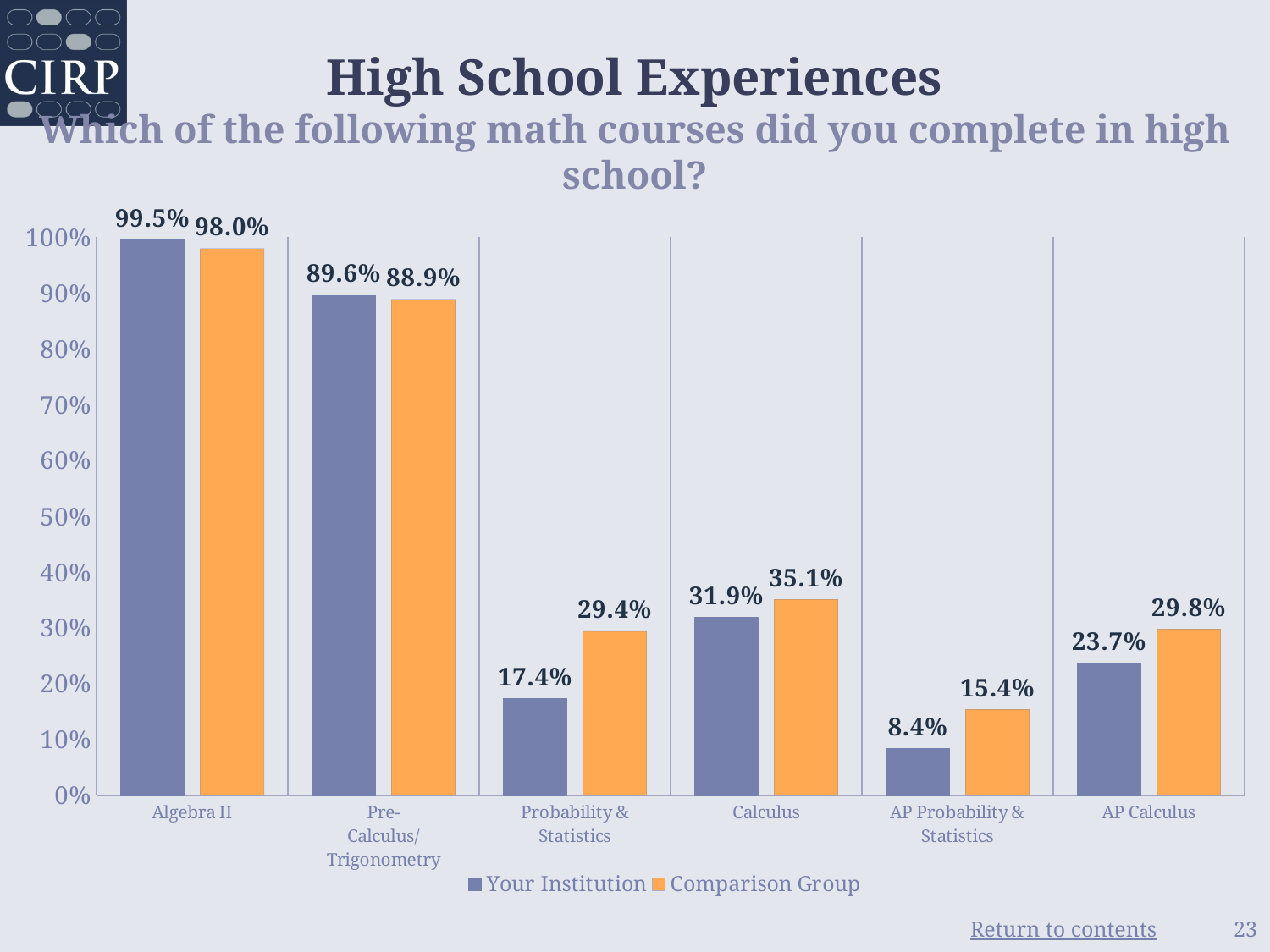
How many series does the legend list? 2 What is the Your Institution value for AP Calculus? 23.7% How many math courses are shown on the x axis? 6 Which math course has the lowest Your Institution value? AP Probability & Statistics Which math course has the highest Comparison Group value? Algebra II For Calculus, which is larger: Your Institution or Comparison Group? Comparison Group Which colour represents the Comparison Group series? orange What is the difference between the Comparison Group and Your Institution values for Probability & Statistics? 12.0% What kind of chart is shown on the slide? bar chart What percentage of Your Institution students completed Algebra II? 99.5% Is the Your Institution value for Calculus greater or less than 40%? less What is the Comparison Group value for AP Probability & Statistics? 15.4%